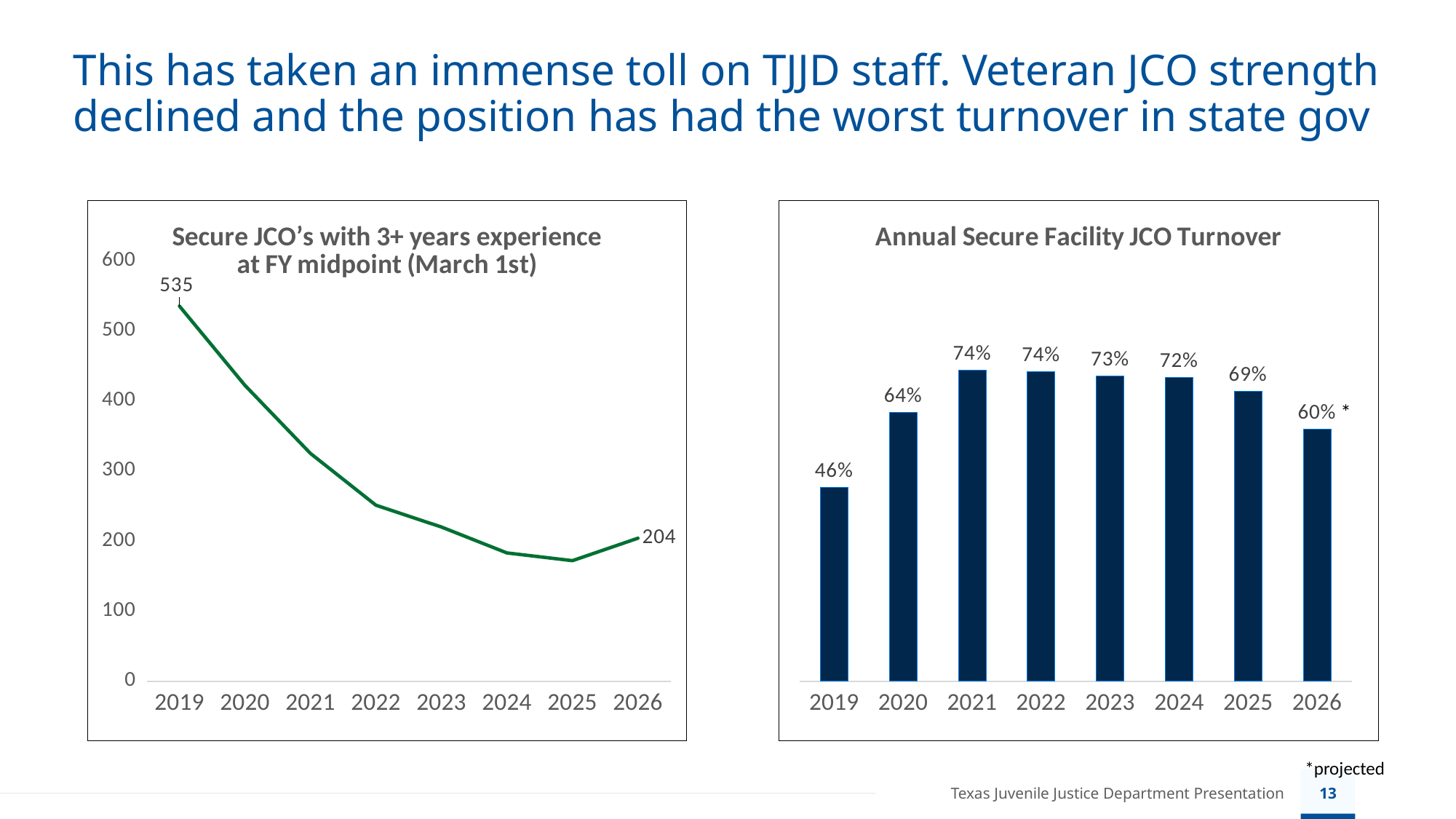
On the left chart, is the value for 2022 greater or less than 300? less What kind of chart is the left chart? Line chart On the Annual Secure Facility JCO Turnover chart, what is the turnover for 2019? 46% On the left chart, what is the value for 2026? 204 On the left chart, what is the value for 2019? 535 On the left chart, what is the difference between the 2019 value and the 2026 value? 331 On the left chart, do the values generally rise or fall from 2019 to 2025? Fall On the left chart, is the value for 2025 greater or less than 200? less How many years are shown on the Annual Secure Facility JCO Turnover chart? 8 On the Annual Secure Facility JCO Turnover chart, which year has higher turnover, 2023 or 2025? 2023 On the Annual Secure Facility JCO Turnover chart, by how many percentage points did turnover increase from 2019 to 2020? 18 percentage points On the Annual Secure Facility JCO Turnover chart, which year has the lowest turnover? 2019